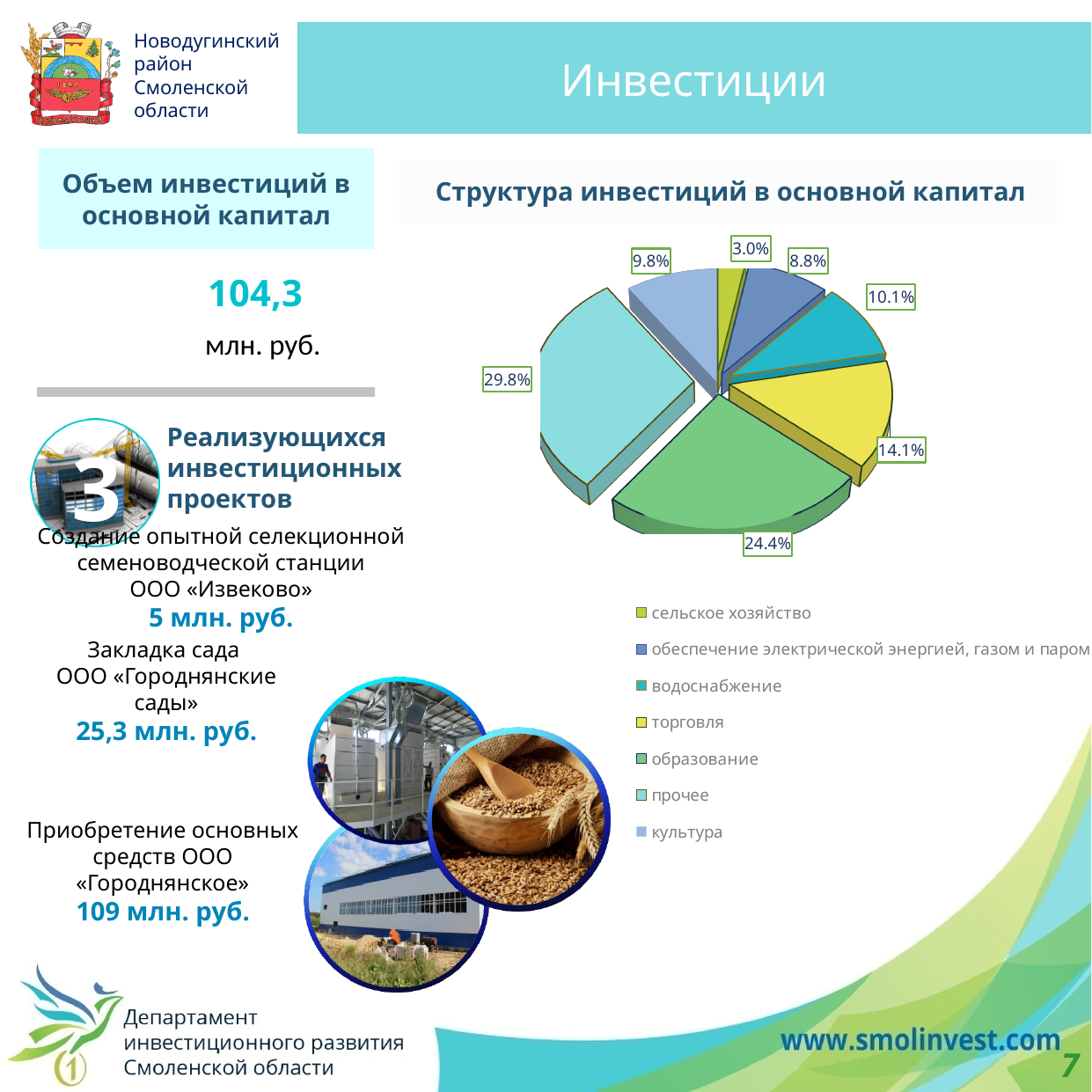
In the pie chart "Структура инвестиций в основной капитал", which category has the largest share? прочее In the pie chart "Структура инвестиций в основной капитал", what colour is the "торговля" slice? yellow In the pie chart "Структура инвестиций в основной капитал", what share does "образование" have? 24.4% What kind of chart is shown under the title "Структура инвестиций в основной капитал"? pie chart In the pie chart "Структура инвестиций в основной капитал", what share does "прочее" have? 29.8% In the pie chart "Структура инвестиций в основной капитал", which category has the smallest share? сельское хозяйство In the pie chart "Структура инвестиций в основной капитал", what share does "сельское хозяйство" have? 3.0% In the pie chart "Структура инвестиций в основной капитал", which has the larger share: "культура" or "обеспечение электрической энергией, газом и паром"? культура In the pie chart "Структура инвестиций в основной капитал", what share does "водоснабжение" have? 10.1% In the pie chart "Структура инвестиций в основной капитал", what share does "торговля" have? 14.1% How many categories does the legend of the pie chart "Структура инвестиций в основной капитал" list? 7 In the pie chart "Структура инвестиций в основной капитал", what is the difference in percentage points between "прочее" and "образование"? 5.4